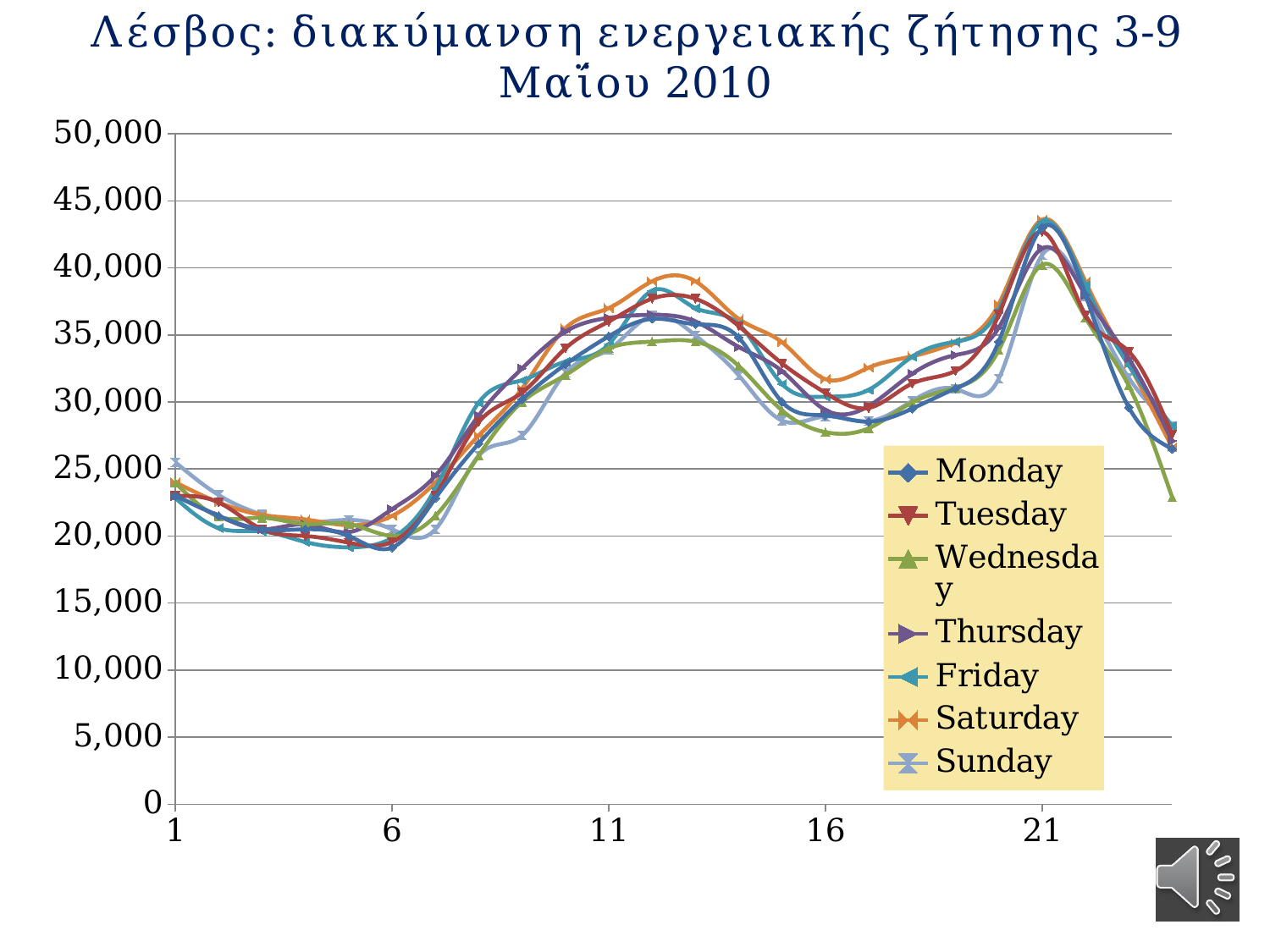
Is the value for Wednesday at hour 24 greater or less than 25,000? less Which series is lowest at the last point on the x axis (hour 24)? Wednesday What is the highest value shown on the y axis? 50,000 Do the values rise or fall between hour 21 and hour 24? fall Is the value for Wednesday at hour 17 greater or less than 30,000? less How many series does the legend list? 7 Which series is highest around hour 12? Saturday Is the value for Saturday at hour 21 greater or less than 40,000? greater Do the values rise or fall between hour 17 and hour 21? rise What kind of chart is shown on the slide? line chart Which series is listed last in the legend? Sunday